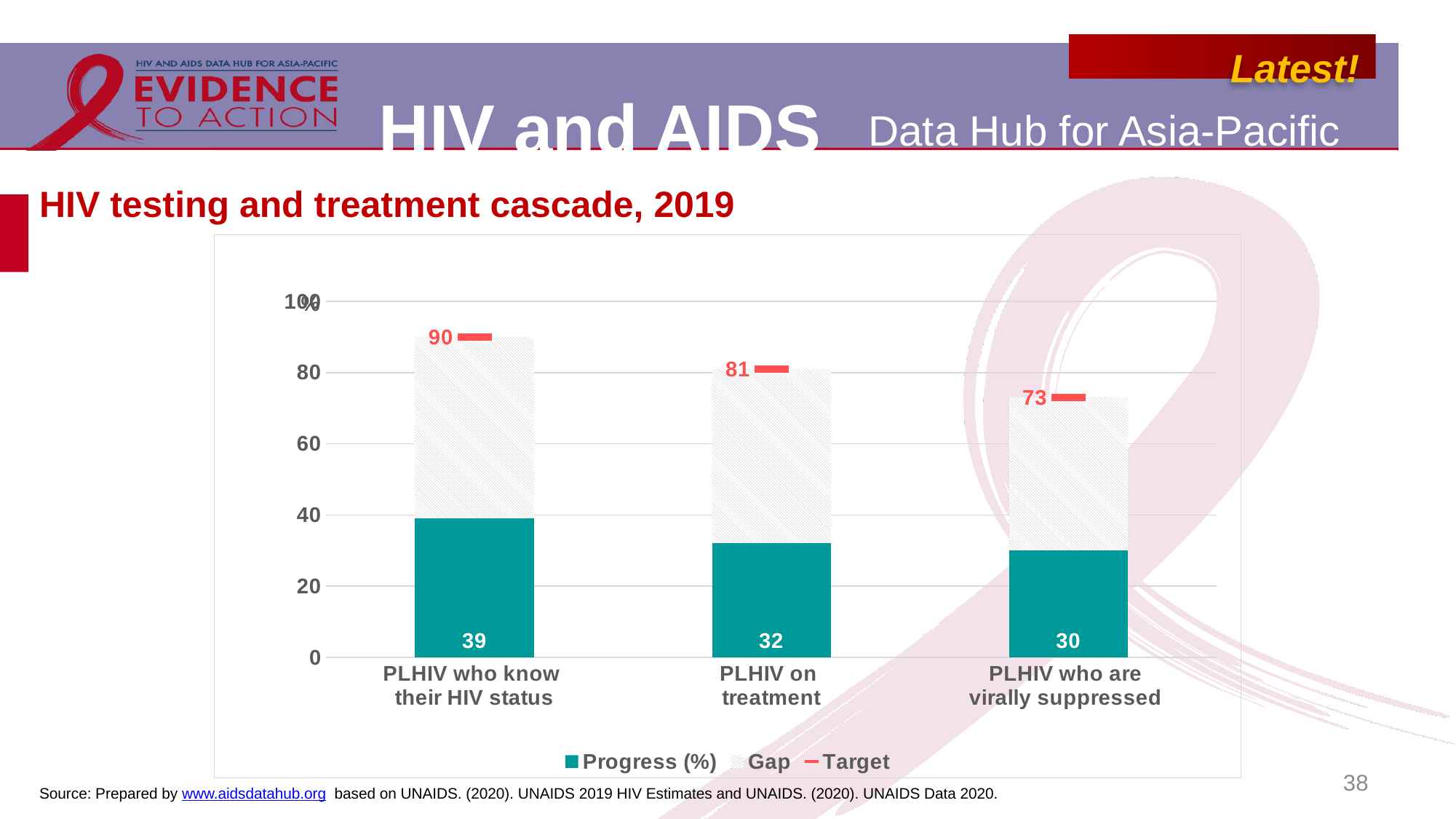
Do the Progress (%) values rise or fall from left to right across the categories? fall Which category has the highest Progress (%) value? PLHIV who know their HIV status What is the Target value for PLHIV who are virally suppressed? 73 What is the Progress (%) value for PLHIV who are virally suppressed? 30 How many series does the legend list? 3 Is the Target value for PLHIV on treatment larger or smaller than the Target value for PLHIV who are virally suppressed? larger What is the Progress (%) value for PLHIV who know their HIV status? 39 How many categories are shown on the x axis? 3 What is the Progress (%) value for PLHIV on treatment? 32 What is the Target value for PLHIV who know their HIV status? 90 Which category has the lowest Target value? PLHIV who are virally suppressed What is the difference between the Progress (%) values for PLHIV who know their HIV status and PLHIV who are virally suppressed? 9